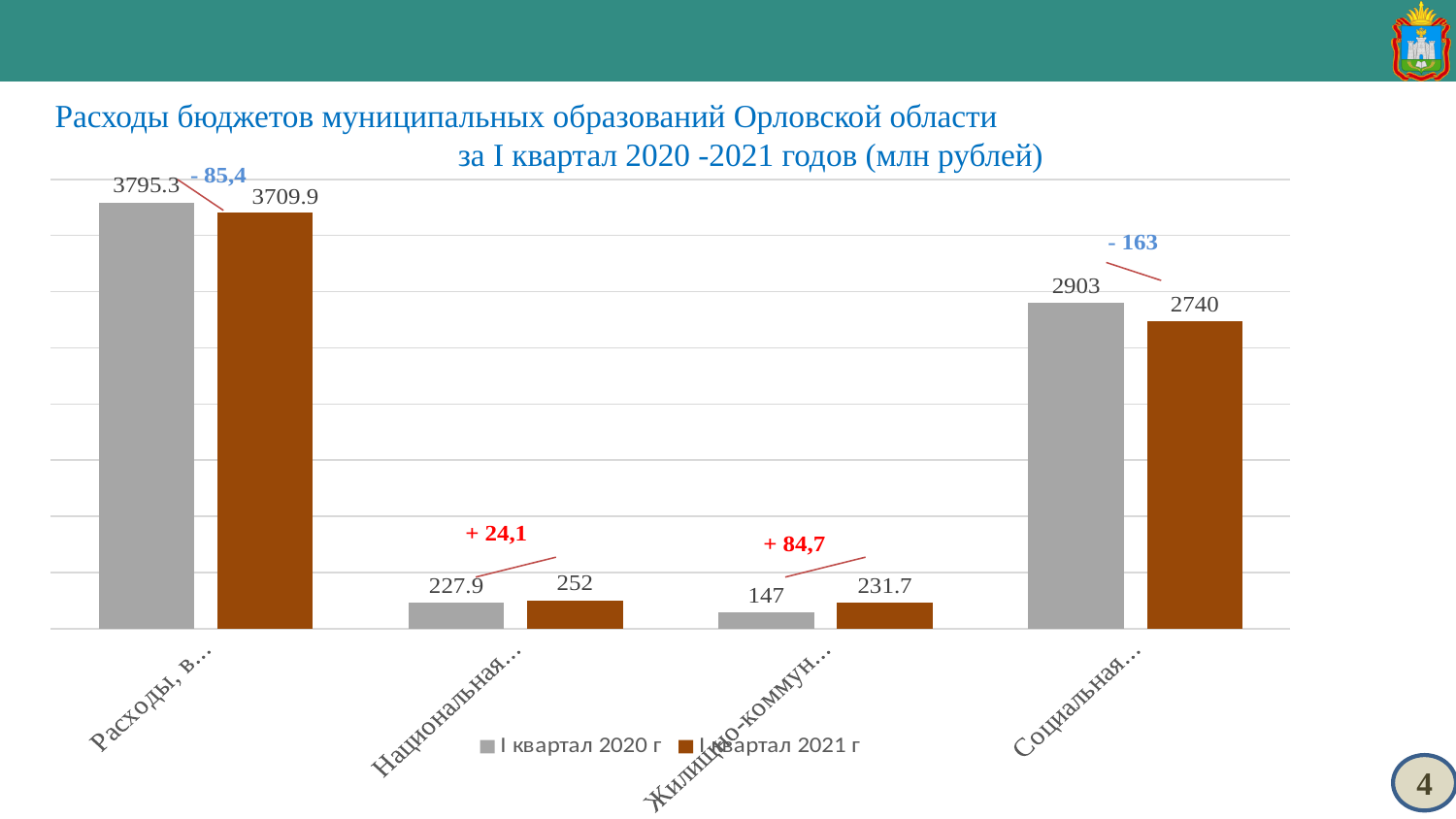
How many series does the legend list? 2 What is the value for I квартал 2021 г in the "Социальная..." category? 2740 Which category has the lowest value for I квартал 2020 г? Жилищно-коммун... What is the value for I квартал 2020 г in the "Национальная..." category? 227.9 What kind of chart is shown on the slide? Bar chart How many categories are shown on the x axis of the chart? 4 What is the value for I квартал 2021 г in the "Жилищно-коммун..." category? 231.7 In the "Социальная..." category, which is larger: the I квартал 2020 г value or the I квартал 2021 г value? I квартал 2020 г Which category has the highest value for I квартал 2021 г? Расходы, в... (the first category) What is the difference between the I квартал 2021 г and I квартал 2020 г values in the "Национальная..." category? 24.1 What is the value for I квартал 2020 г in the first category ("Расходы, в...")? 3795.3 By how much does the I квартал 2020 г value exceed the I квартал 2021 г value in the first category ("Расходы, в...")? 85.4